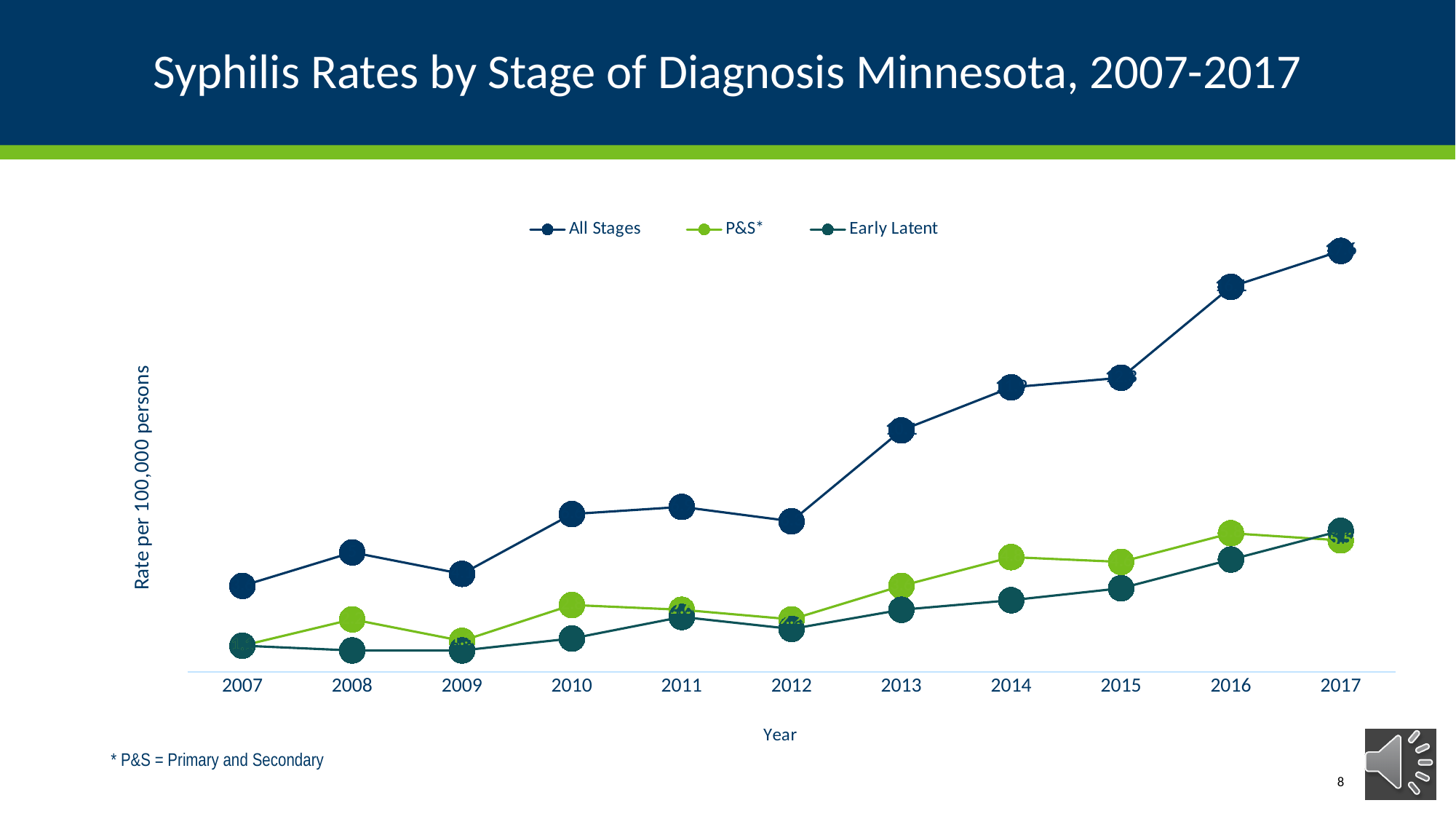
What kind of chart is shown on the slide? Line chart How many series does the legend list? 3 What is the label on the y axis? Rate per 100,000 persons In which year is the All Stages rate lowest? 2007 According to the footnote, what does P&S stand for? Primary and Secondary In which year is the All Stages rate highest? 2017 Does the Early Latent rate rise or fall from 2009 to 2017? Rise Which series has the higher rate in 2016, P&S* or Early Latent? P&S* Which is larger, the All Stages rate in 2013 or in 2012? 2013 How many years are plotted along the x axis? 11 Which series has the highest rate in every year shown? All Stages Does the All Stages rate generally rise or fall from 2007 to 2017? Rise